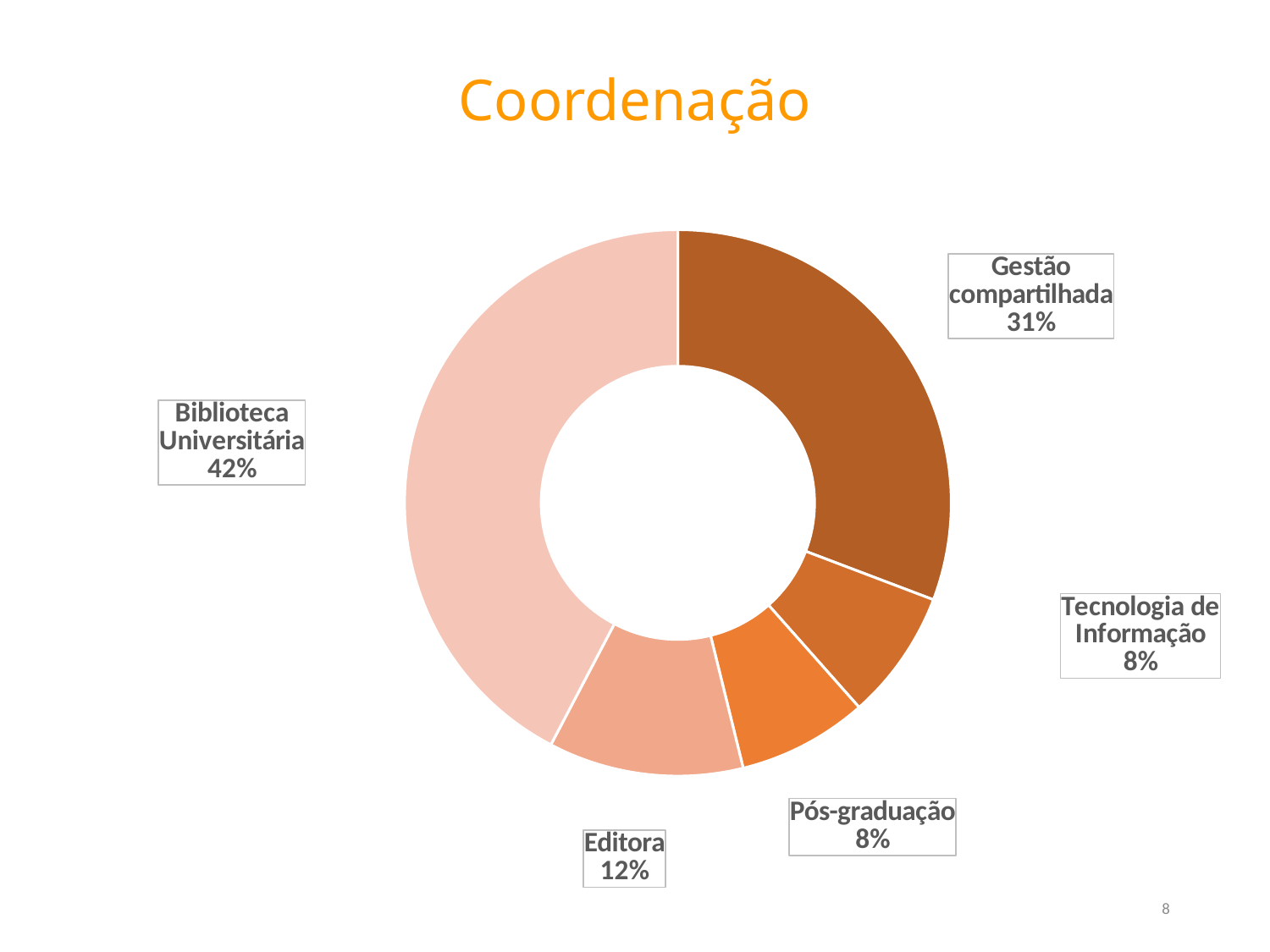
What is the value shown for Tecnologia de Informação? 8% Which category has the largest slice? Biblioteca Universitária What kind of chart is shown on the slide? Pie chart (doughnut) How many categories are shown in the chart? 5 What is the title of the slide? Coordenação Which is larger, Gestão compartilhada or Editora? Gestão compartilhada What is the difference between the Biblioteca Universitária and Gestão compartilhada shares? 11% What is the difference between the Editora and Pós-graduação shares? 4% What is the value shown for Editora? 12% What is the value shown for Gestão compartilhada? 31% Which two categories share the same value of 8%? Tecnologia de Informação and Pós-graduação What share of the pie does Biblioteca Universitária hold? 42%